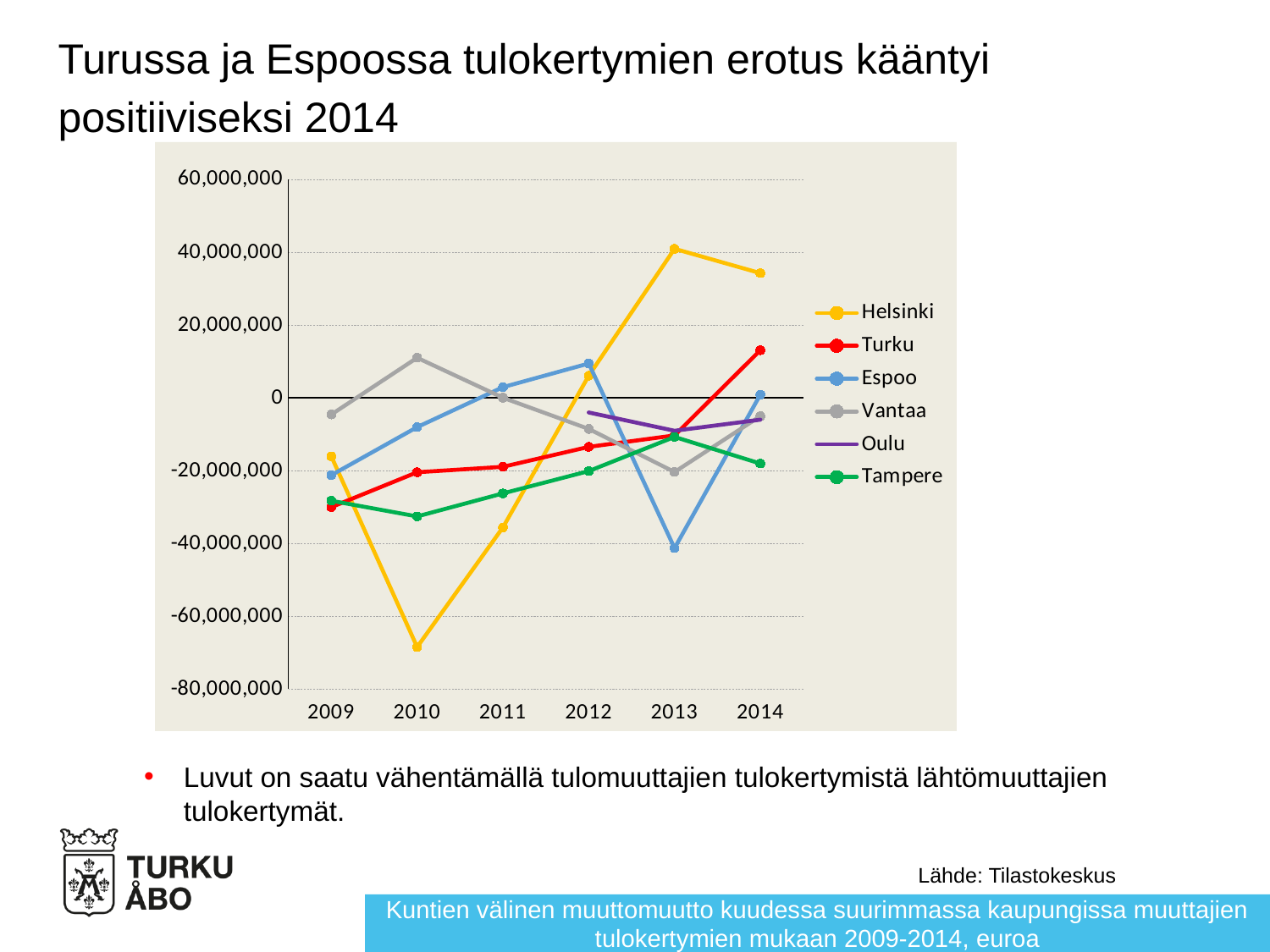
Which city has the highest value in 2010? Vantaa How many years are shown on the x axis? 6 In 2014, which is larger, the value for Turku or the value for Tampere? Turku Which city has the lowest value in 2010? Helsinki Which city has the highest value in 2013? Helsinki Which city has the lowest value in 2013? Espoo How many series does the legend list? 6 Does the value for Turku rise or fall from 2009 to 2014? rise Is the value for Helsinki in 2013 greater or less than 20,000,000? greater Is the value for Helsinki in 2010 greater or less than -60,000,000? less Is the value for Espoo in 2013 greater or less than -20,000,000? less What kind of chart is shown on the slide? line chart